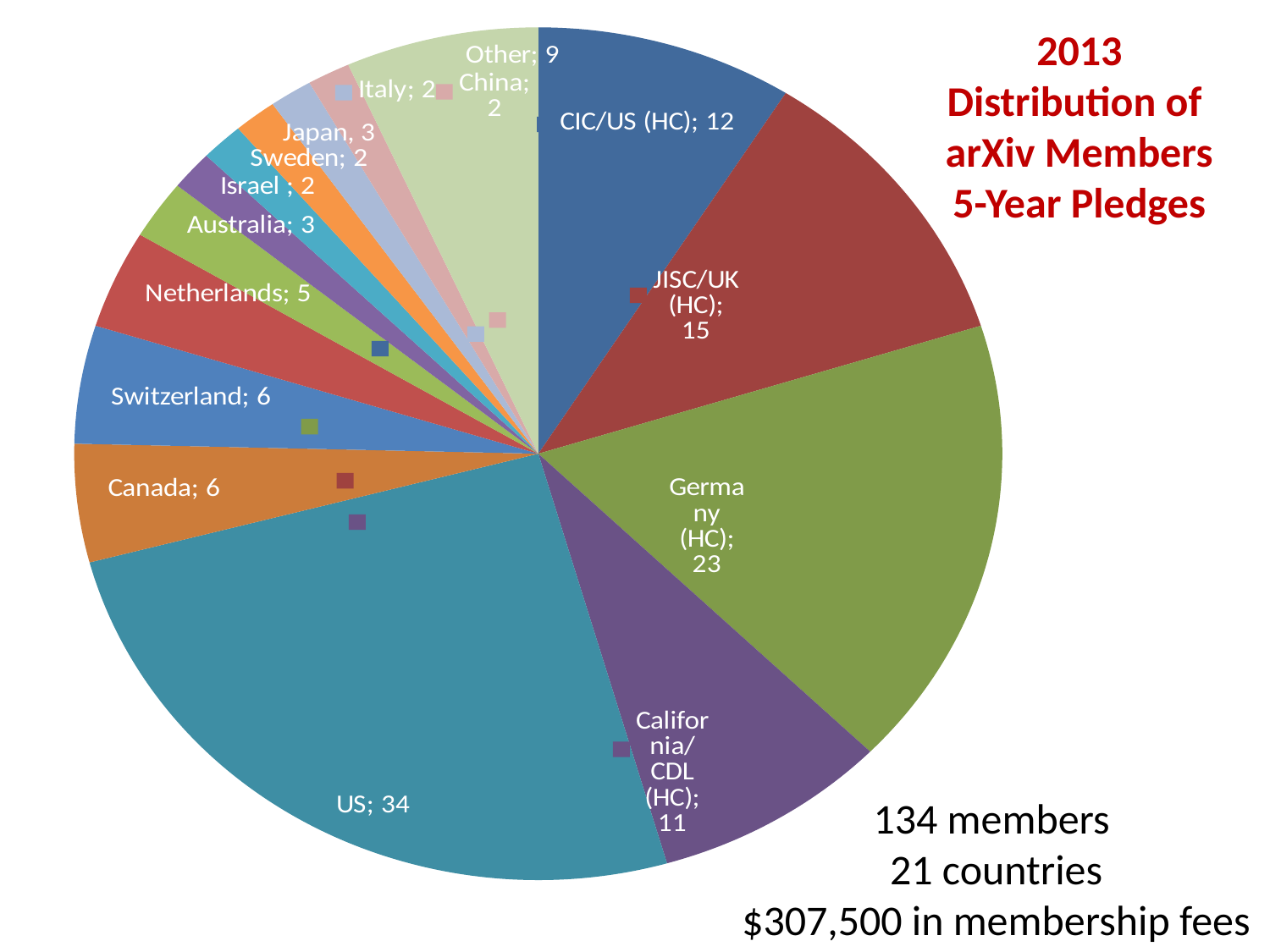
What is the value for JISC/UK (HC)? 15 How many members in total does the slide report? 134 members What is the title of the chart? 2013 Distribution of arXiv Members 5-Year Pledges How many slices does the pie chart have? 15 Which is larger, the value for CIC/US (HC) or the value for California/CDL (HC)? CIC/US (HC) What is the value for US in the pie chart? 34 What type of chart is shown on the slide? Pie chart What is the combined value of Canada and Switzerland? 12 What is the difference between the values for US and Germany (HC)? 11 What is the value for Germany (HC)? 23 What is the value for Netherlands? 5 Which slice of the pie chart is the largest? US